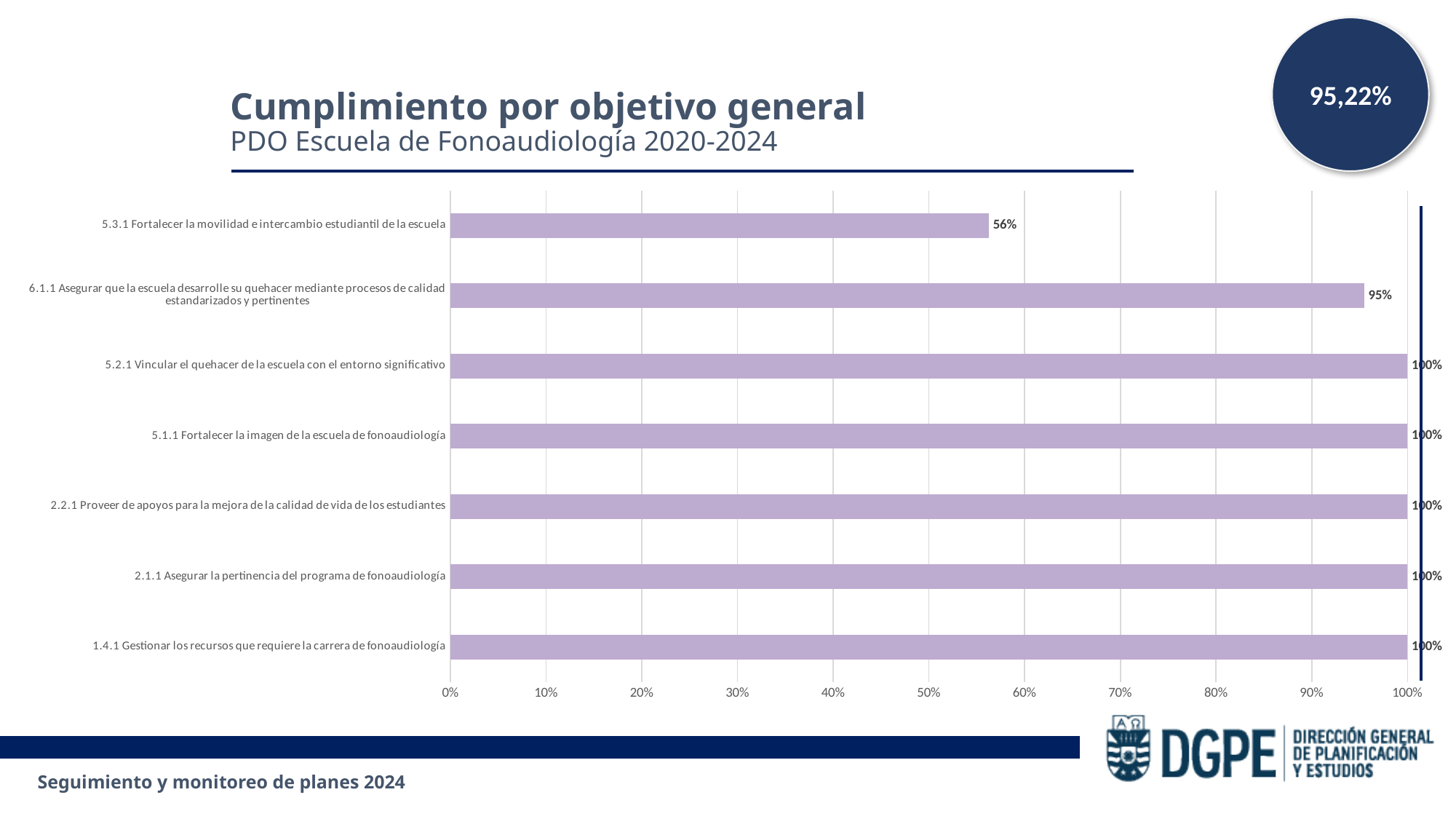
What is the title of the chart? Cumplimiento por objetivo general How many objectives have a value of 100%? 5 Is the value for objective 5.3.1 greater or less than 60%? less Which objective has the lowest value? 5.3.1 Fortalecer la movilidad e intercambio estudiantil de la escuela What is the value for objective 1.4.1 Gestionar los recursos que requiere la carrera de fonoaudiología? 100% What is the difference between the values for objective 5.2.1 and objective 6.1.1? 5% What is the value for objective 6.1.1 Asegurar que la escuela desarrolle su quehacer mediante procesos de calidad estandarizados y pertinentes? 95% What kind of chart is shown on the slide? Bar chart What is the difference between the values for objective 6.1.1 and objective 5.3.1? 39% How many objectives are shown in the chart? 7 What is the value for objective 5.3.1 Fortalecer la movilidad e intercambio estudiantil de la escuela? 56% Which is larger, the value for objective 6.1.1 or the value for objective 5.3.1? 6.1.1